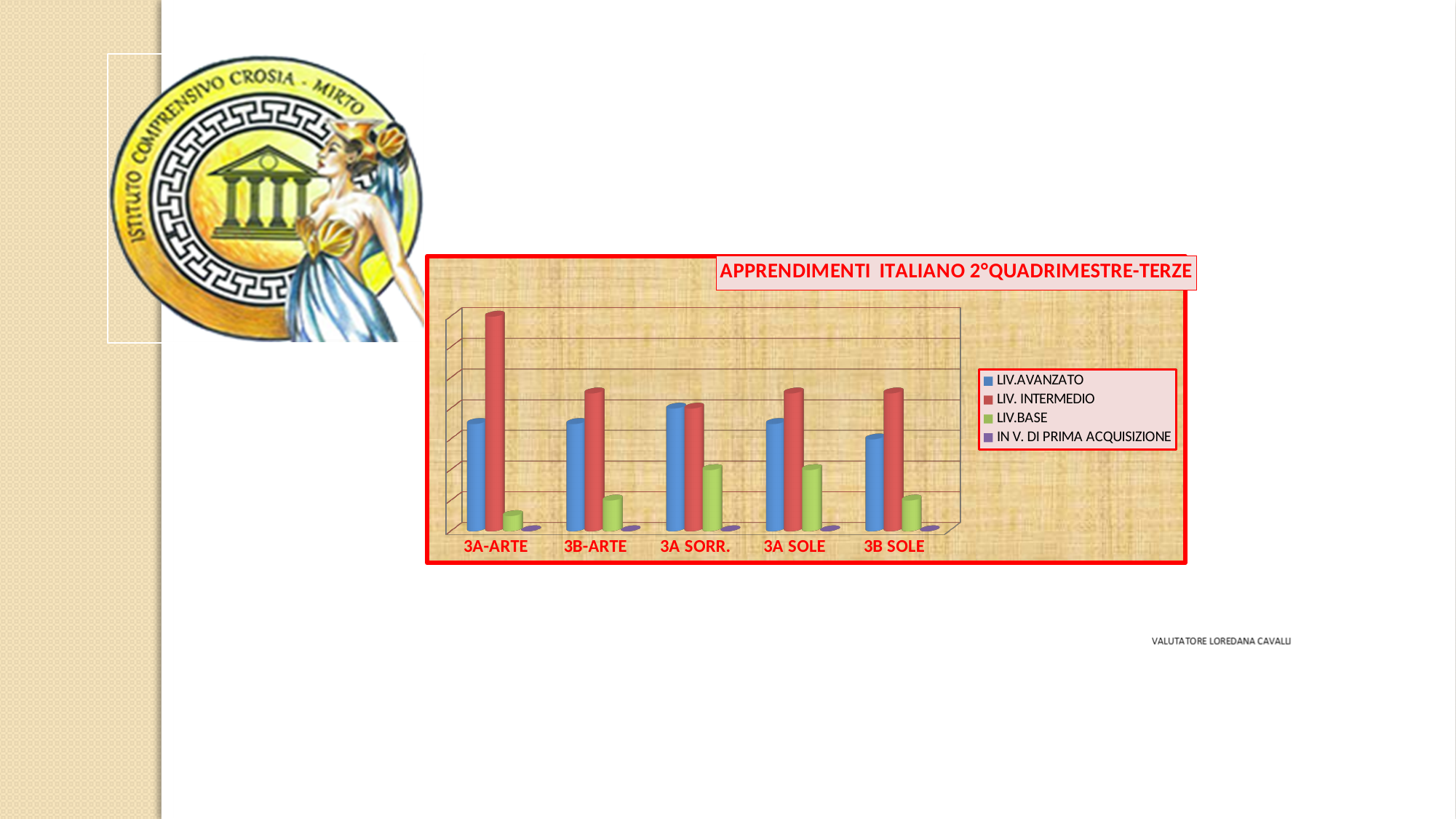
Which class has the shortest LIV.AVANZATO bar? 3B SOLE Which class has the tallest LIV. INTERMEDIO bar? 3A-ARTE What kind of chart is shown on the slide? bar chart Which class has the shortest LIV.BASE bar? 3A-ARTE For 3B SOLE, which is larger, LIV.AVANZATO or LIV. INTERMEDIO? LIV. INTERMEDIO For 3A SORR., which is larger, LIV.AVANZATO or LIV.BASE? LIV.AVANZATO How many series does the chart's legend list? 4 What is the title of the chart? APPRENDIMENTI ITALIANO 2°QUADRIMESTRE-TERZE Which class has the tallest LIV.AVANZATO bar? 3A SORR. Which series is shown in green in the chart's legend? LIV.BASE How many classes (categories) are shown on the x axis of the chart? 5 For 3A-ARTE, which is larger, LIV.AVANZATO or LIV. INTERMEDIO? LIV. INTERMEDIO